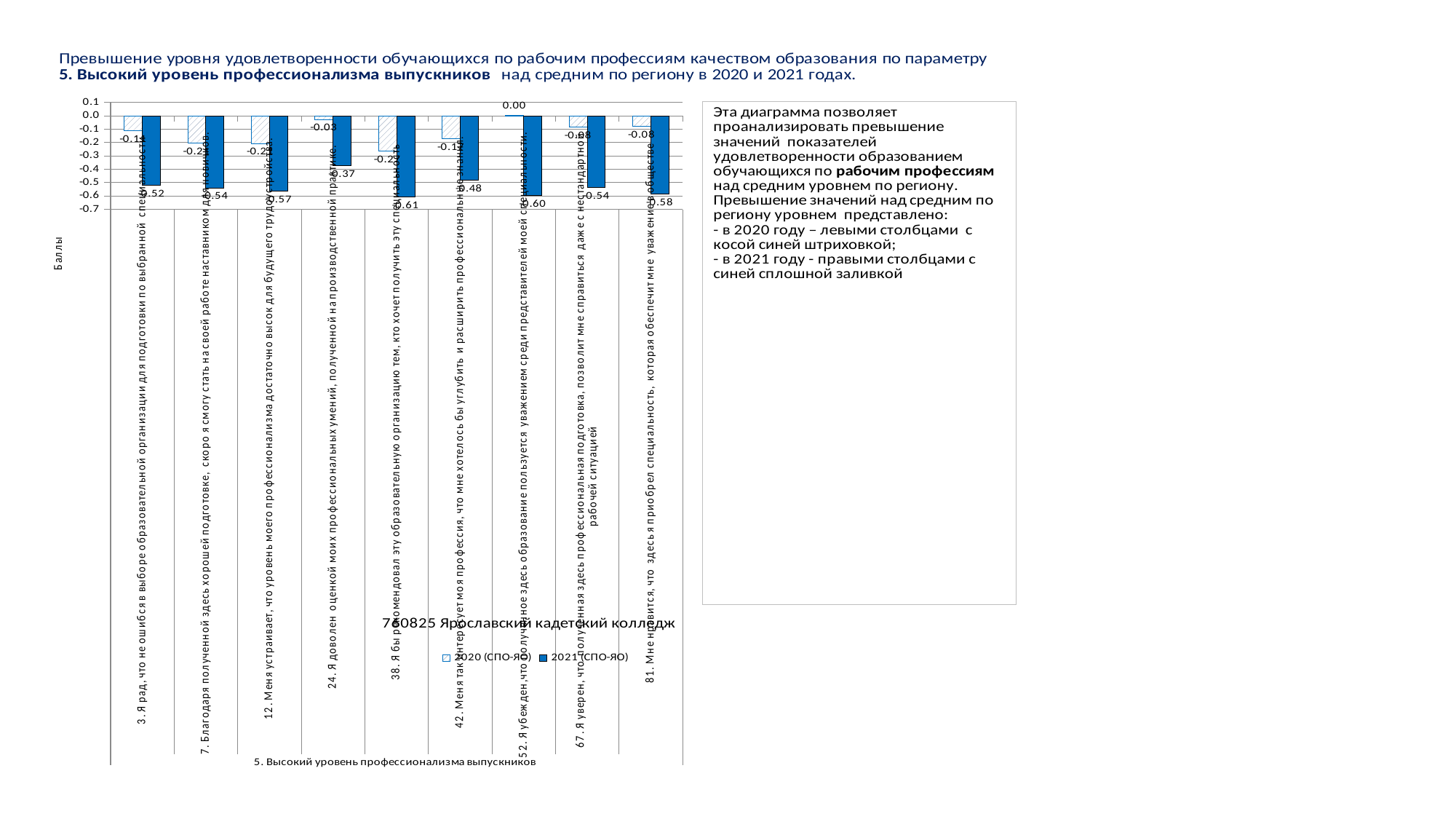
How many categories (statements) are plotted on the chart? 9 What is the 2021 (СПО-ЯО) value for statement 38 ("Я бы рекомендовал эту образовательную организацию...")? -0.61 What are the two legend entries of the chart? 2020 (СПО-ЯО) and 2021 (СПО-ЯО) How many series does the chart legend list? 2 What is the difference between the 2020 and 2021 values for statement 24? 0.34 What kind of chart is shown on the slide? bar chart Which is larger: the 2021 value for statement 24 or the 2021 value for statement 52? statement 24 What is the 2021 (СПО-ЯО) value for statement 24 ("Я доволен оценкой моих профессиональных умений...")? -0.37 What is the 2021 (СПО-ЯО) value for statement 81 ("Мне нравится, что здесь я приобрел специальность...")? -0.58 What is the 2020 (СПО-ЯО) value for statement 52 ("Я убежден, что полученное здесь образование пользуется уважением...")? 0.00 Which statement has the highest 2021 (СПО-ЯО) value? 24. Я доволен оценкой моих профессиональных умений, полученной на производственной практике What is the difference between the 2020 and 2021 values for statement 67? 0.46